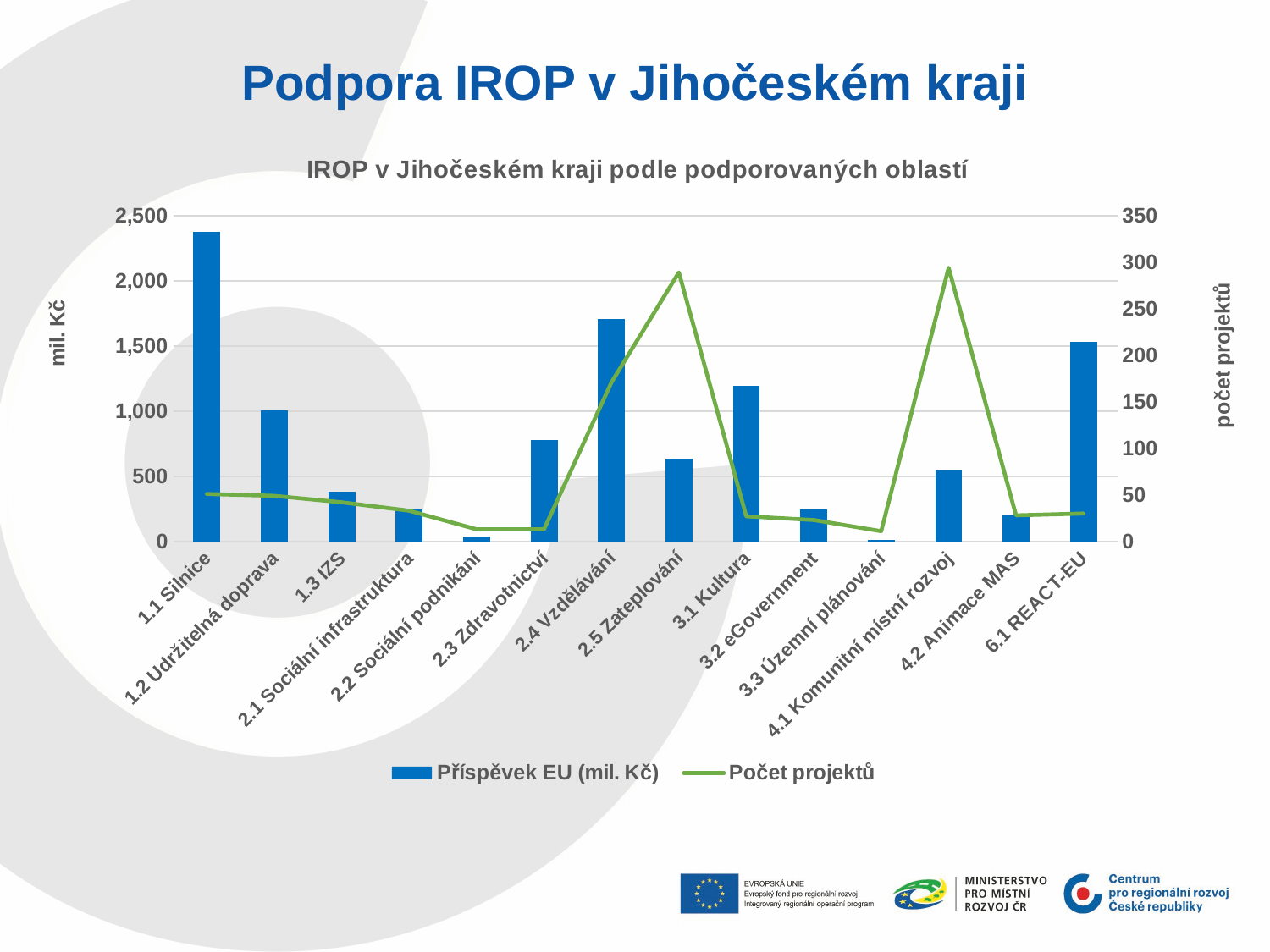
Is the Příspěvek EU (mil. Kč) value for 4.1 Komunitní místní rozvoj greater or less than 1,000? less Which has the larger Příspěvek EU (mil. Kč) bar, 6.1 REACT-EU or 3.1 Kultura? 6.1 REACT-EU What kind of chart is shown on the slide? Combined bar and line chart Is the Příspěvek EU (mil. Kč) value for 1.1 Silnice greater or less than 2,000? greater Which category has the highest Příspěvek EU (mil. Kč) bar? 1.1 Silnice How many series does the chart legend list? 2 What is the title of the chart? IROP v Jihočeském kraji podle podporovaných oblastí Is the Počet projektů value for 2.5 Zateplování greater or less than 250? greater Which has the larger Počet projektů value, 2.4 Vzdělávání or 1.1 Silnice? 2.4 Vzdělávání How many categories are shown on the x axis of the chart? 14 Which category has the lowest Příspěvek EU (mil. Kč) bar? 3.3 Územní plánování